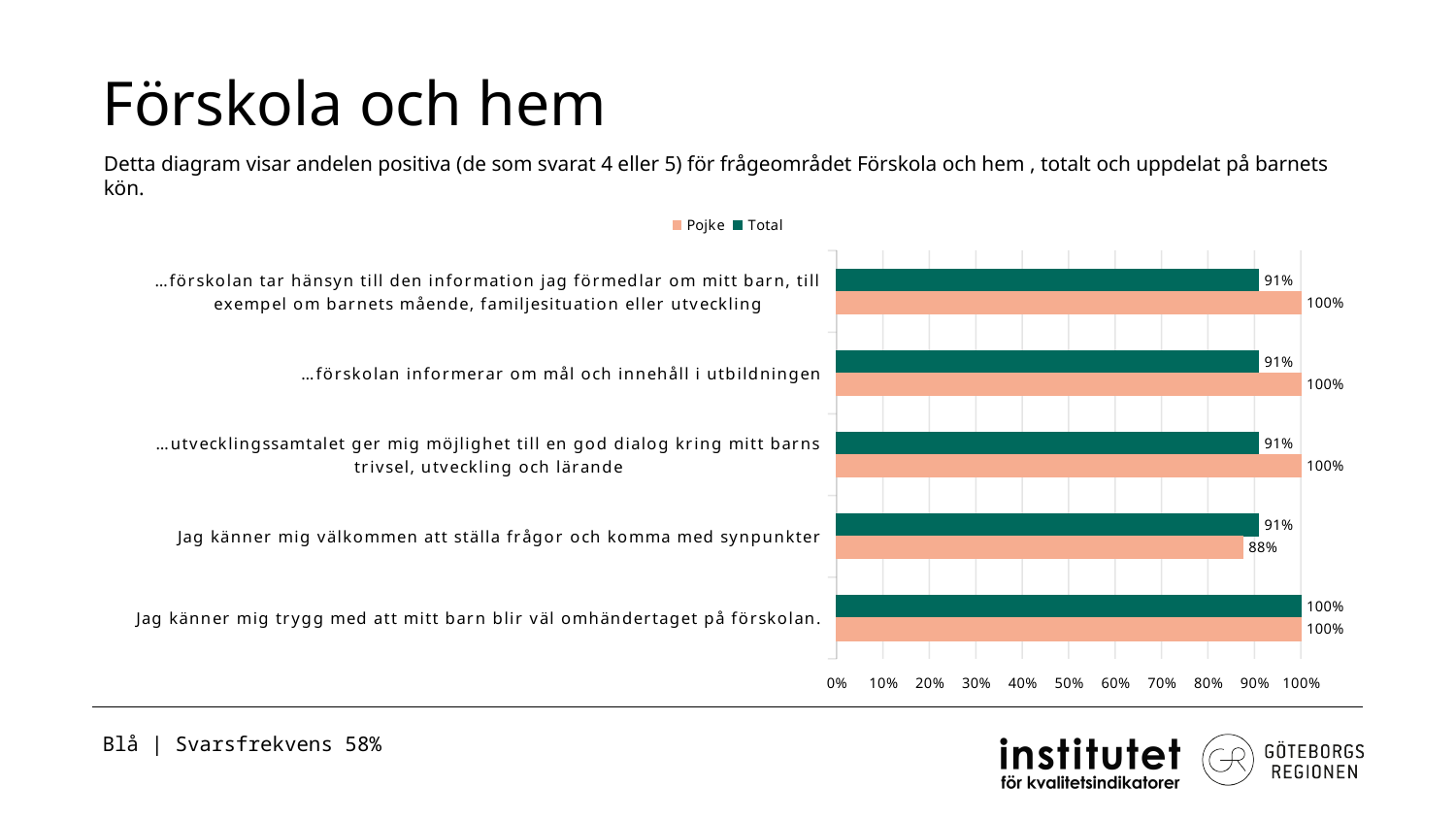
What is the Pojke value for "Jag känner mig välkommen att ställa frågor och komma med synpunkter"? 88% What kind of chart is shown on the slide? Bar chart Which series is shown in dark green in the legend? Total How many series does the legend list? 2 What is the Pojke value for "…förskolan informerar om mål och innehåll i utbildningen"? 100% What is the Total value for "Jag känner mig trygg med att mitt barn blir väl omhändertaget på förskolan."? 100% What is the Total value for "Jag känner mig välkommen att ställa frågor och komma med synpunkter"? 91% What is the Total value for "…utvecklingssamtalet ger mig möjlighet till en god dialog kring mitt barns trivsel, utveckling och lärande"? 91% Which category has the lowest Pojke value? Jag känner mig välkommen att ställa frågor och komma med synpunkter How many categories are shown in the chart? 5 For "Jag känner mig välkommen att ställa frågor och komma med synpunkter", which is larger, the Pojke value or the Total value? Total What is the difference between the Pojke and Total values for "…förskolan tar hänsyn till den information jag förmedlar om mitt barn, till exempel om barnets mående, familjesituation eller utveckling"? 9 percentage points